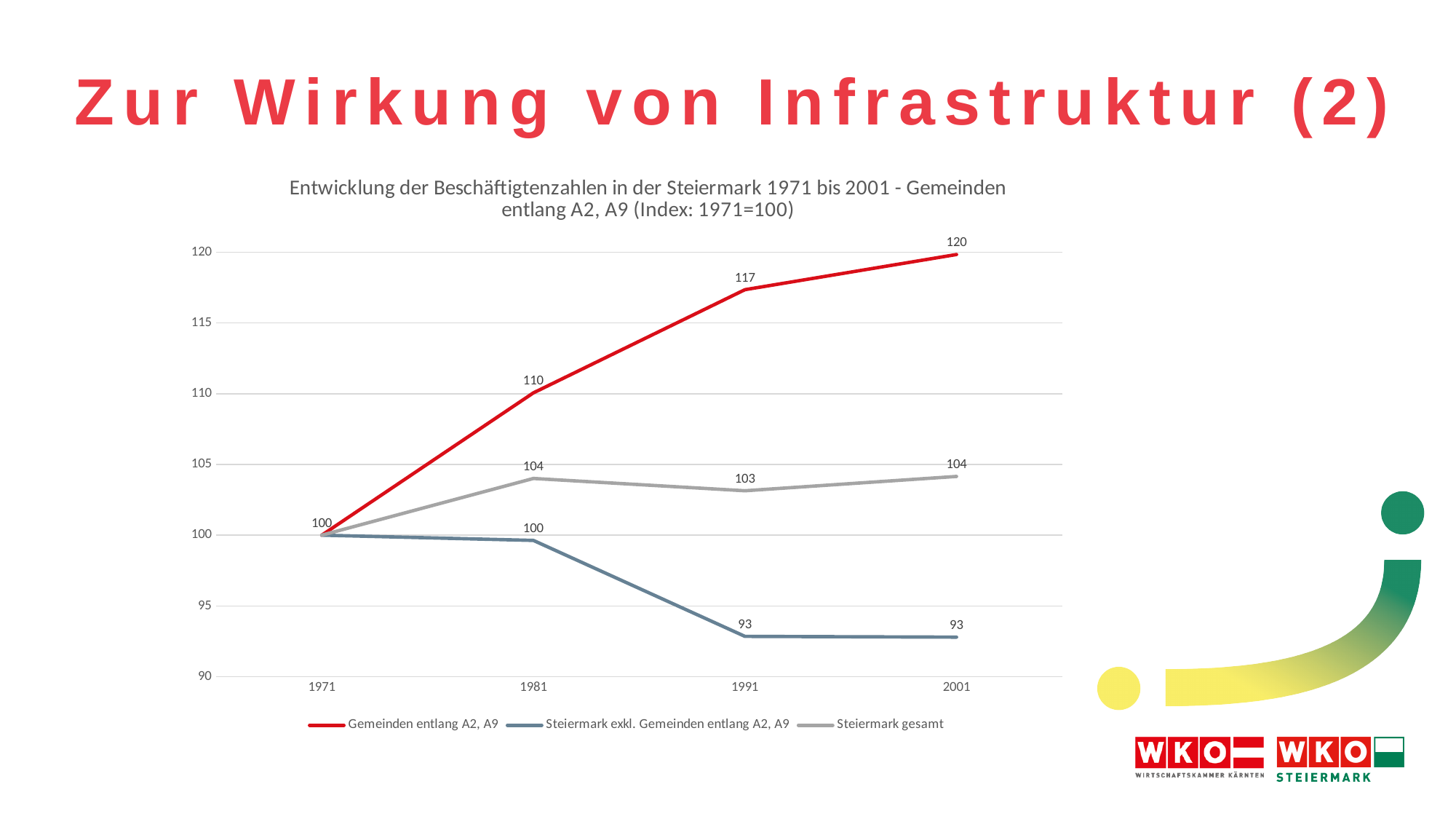
Which series has the larger value in 1991: Steiermark gesamt or Steiermark exkl. Gemeinden entlang A2, A9? Steiermark gesamt What is the difference between Gemeinden entlang A2, A9 and Steiermark exkl. Gemeinden entlang A2, A9 in 2001? 27 What is the value for Steiermark gesamt in 1981? 104 What is the value for Gemeinden entlang A2, A9 in 2001? 120 What type of chart is shown on the slide? line chart How many series does the legend list? 3 What colour is the line for Gemeinden entlang A2, A9? red How many years are shown on the x axis? 4 What is the value for Gemeinden entlang A2, A9 in 1981? 110 In which year does Gemeinden entlang A2, A9 reach its highest value? 2001 What is the value for Steiermark exkl. Gemeinden entlang A2, A9 in 1991? 93 Does the value for Gemeinden entlang A2, A9 rise or fall from 1971 to 2001? rise